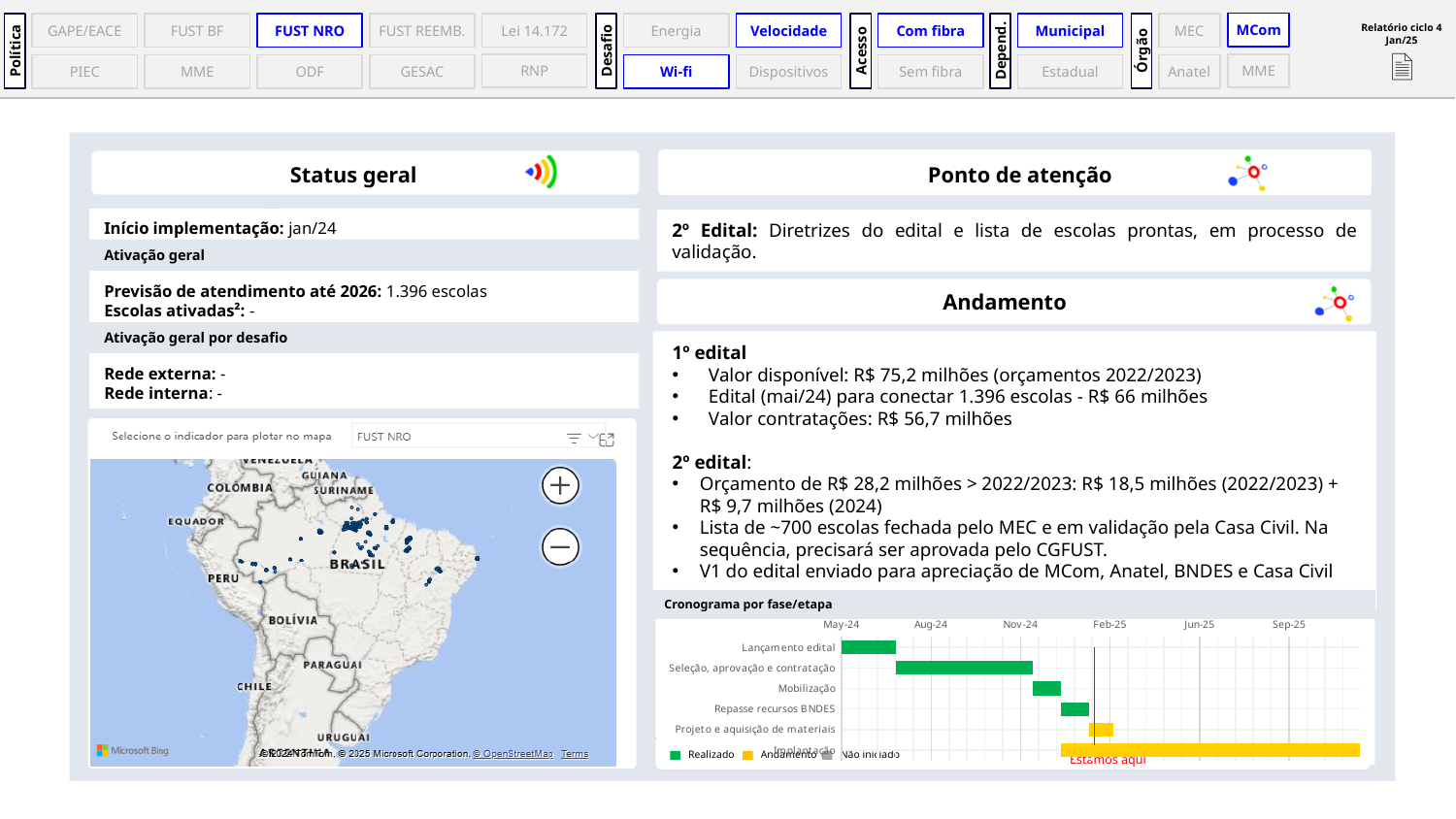
What kind of chart is 'Cronograma por fase/etapa'? Gantt (horizontal bar) chart What are the legend entries of the 'Cronograma por fase/etapa' chart? Realizado, Andamento, Não iniciado How many entries does the legend of the 'Cronograma por fase/etapa' chart list? 3 In the 'Cronograma por fase/etapa' chart, which phases are shown in the 'Andamento' (yellow) status? Projeto e aquisição de materiais and Implantação In the 'Cronograma por fase/etapa' chart, what status is shown for 'Mobilização'? Realizado In the 'Cronograma por fase/etapa' chart, which phase has the longest bar? Implantação In the 'Cronograma por fase/etapa' chart, which phase is the last to start on the timeline? Projeto e aquisição de materiais In the 'Cronograma por fase/etapa' chart, which bar is longer: 'Lançamento edital' or 'Seleção, aprovação e contratação'? Seleção, aprovação e contratação What is the title of the chart at the bottom right of the slide? Cronograma por fase/etapa In the 'Cronograma por fase/etapa' chart, what is the first date label on the horizontal axis? May-24 In the 'Cronograma por fase/etapa' chart, how many phases (rows) are listed on the vertical axis? 6 In the 'Cronograma por fase/etapa' chart, which phase starts first on the timeline? Lançamento edital